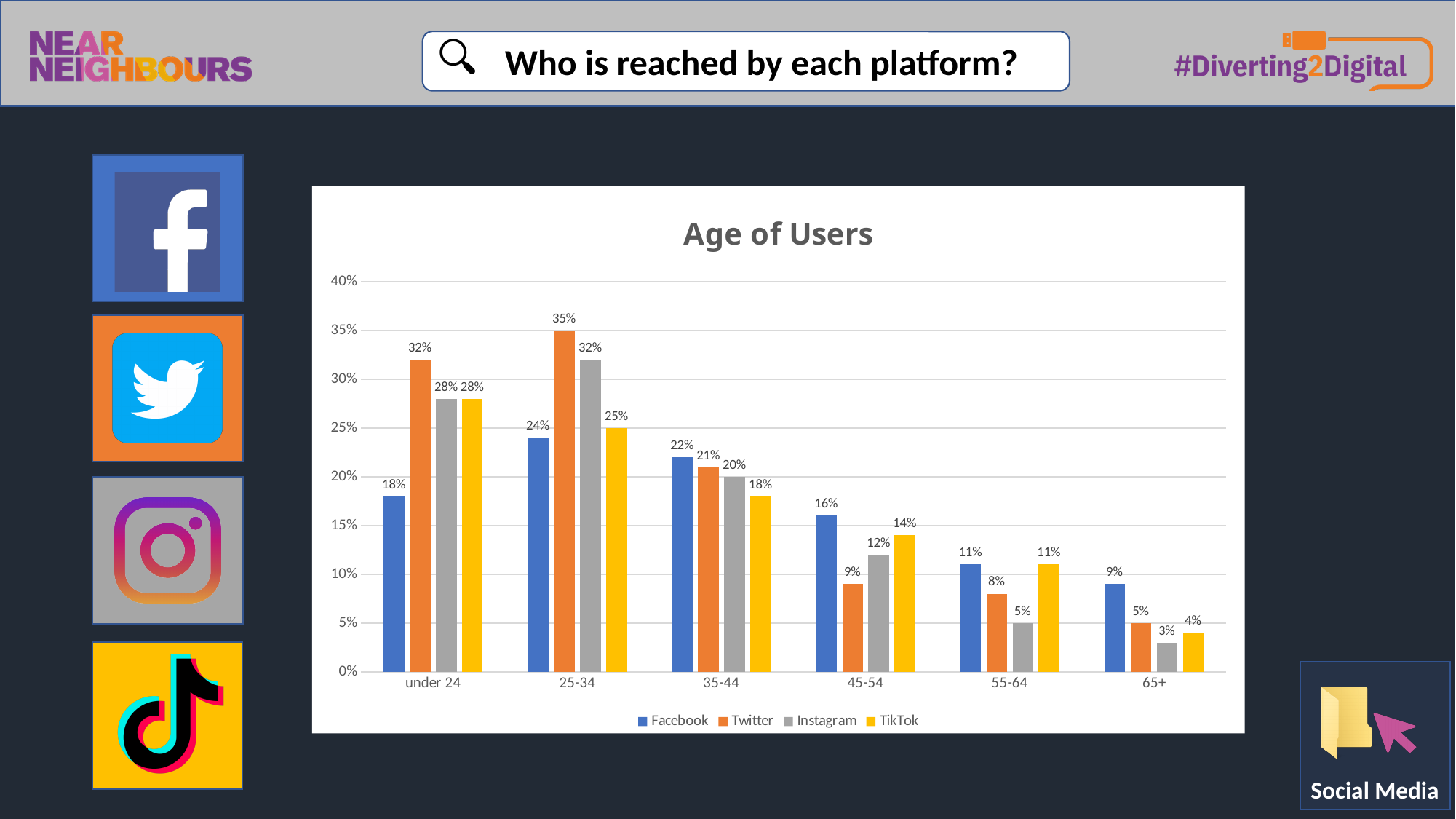
In the 55-64 age group, which is larger: the Facebook value or the Instagram value? Facebook How many age groups are shown on the x axis? 6 What is the value for Instagram in the 65+ age group? 3% What is the value for TikTok in the 45-54 age group? 14% How many series does the legend list? 4 What is the title of the chart? Age of Users What is the value for Twitter in the 25-34 age group? 35% Which age group has the lowest value for Twitter? 65+ Which age group has the highest value for Facebook? 25-34 What is the difference between the Twitter and Facebook values in the under 24 age group? 14% What is the value for Facebook in the under 24 age group? 18% What kind of chart is shown on the slide? Bar chart